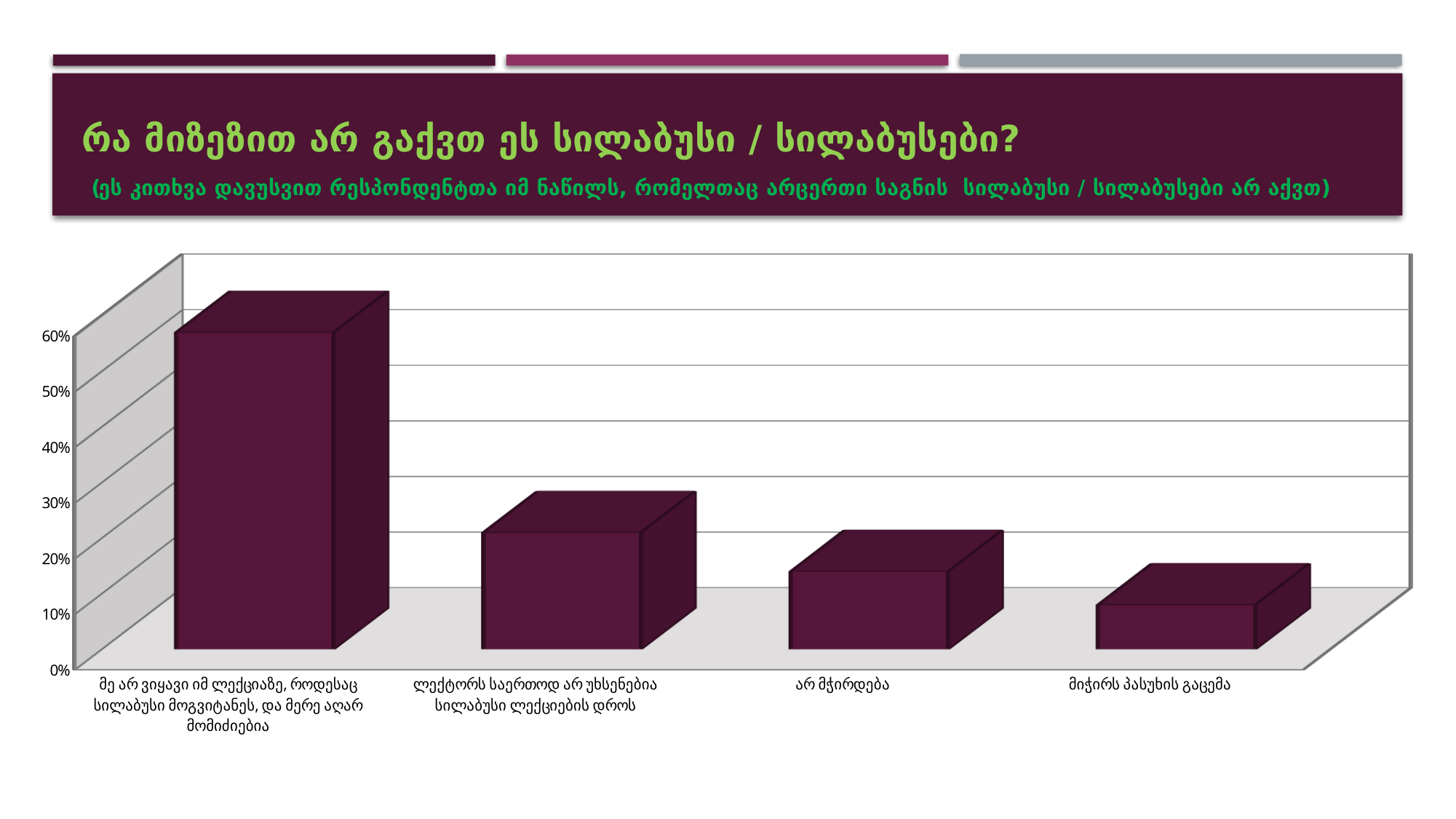
Which category has the lowest value in the chart? მიჭირს პასუხის გაცემა Do the bar values rise or fall from left to right along the x axis? fall How many categories are shown on the x axis of the chart? 4 Which is larger: the value for "არ მჭირდება" or the value for "მიჭირს პასუხის გაცემა"? არ მჭირდება What is the title of the slide above the chart? რა მიზეზით არ გაქვთ ეს სილაბუსი / სილაბუსები? Which category has the highest value in the chart? მე არ ვიყავი იმ ლექციაზე, როდესაც სილაბუსი მოგვიტანეს, და მერე აღარ მომიძიებია Is the value for "ლექტორს საერთოდ არ უხსენებია სილაბუსი ლექციების დროს" greater or less than 30%? less Is the value for "მიჭირს პასუხის გაცემა" greater or less than 20%? less Is the value for "არ მჭირდება" greater or less than 20%? less What kind of chart is shown on the slide? bar chart